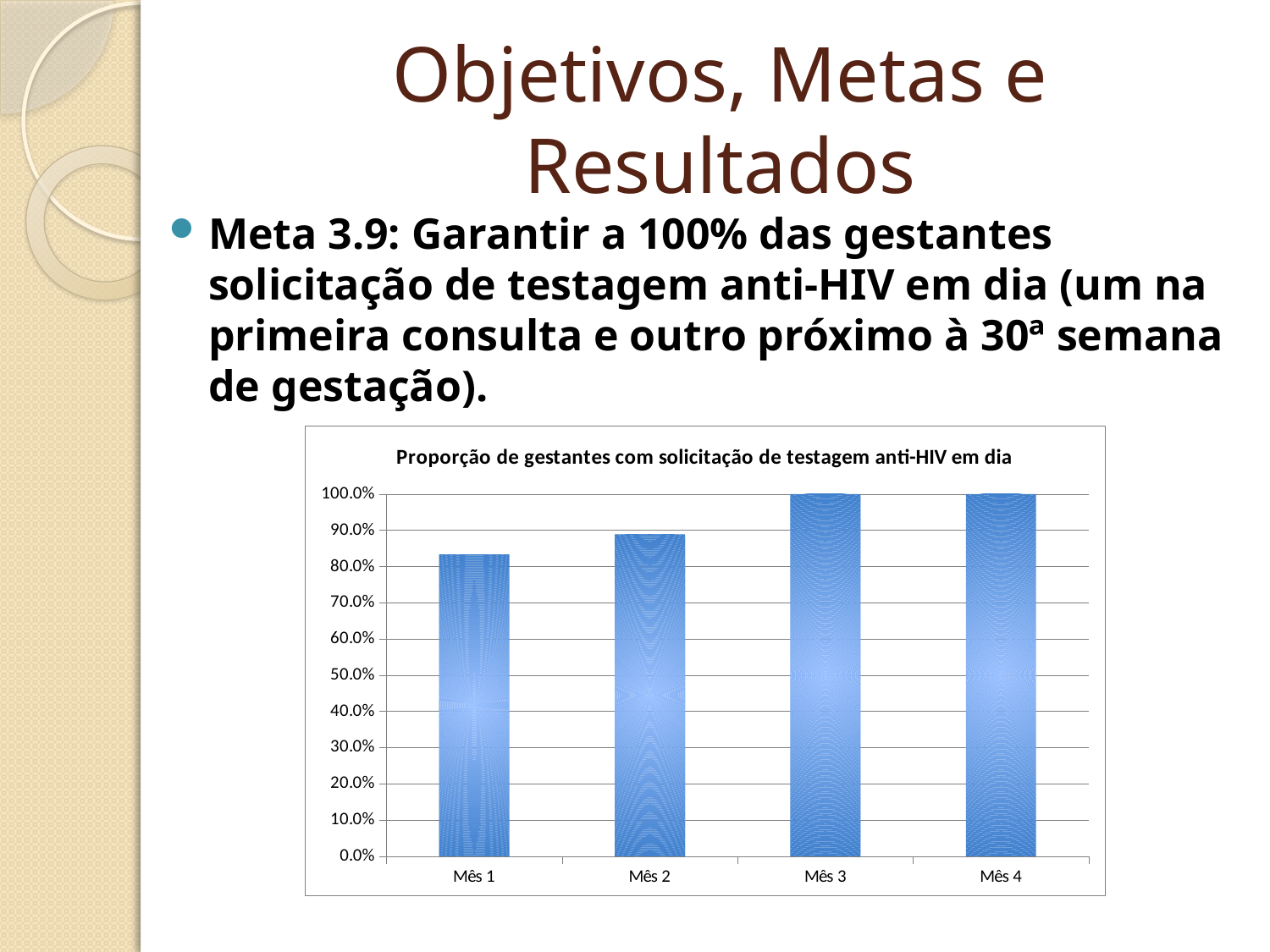
Which is larger, the value for Mês 1 or the value for Mês 2? Mês 2 What is the title of the chart? Proporção de gestantes com solicitação de testagem anti-HIV em dia Is the value for Mês 1 greater or less than 90.0%? less Is the value for Mês 1 greater or less than 80.0%? greater What kind of chart is shown on the slide? bar chart What is the value for Mês 4? 100.0% How many months (categories) are plotted on the x axis? 4 What is the highest value shown on the y axis? 100.0% What is the value for Mês 3? 100.0% Which month has the lowest value? Mês 1 Is the value for Mês 2 greater or less than 80.0%? greater Do the values rise or fall from Mês 1 to Mês 4? rise